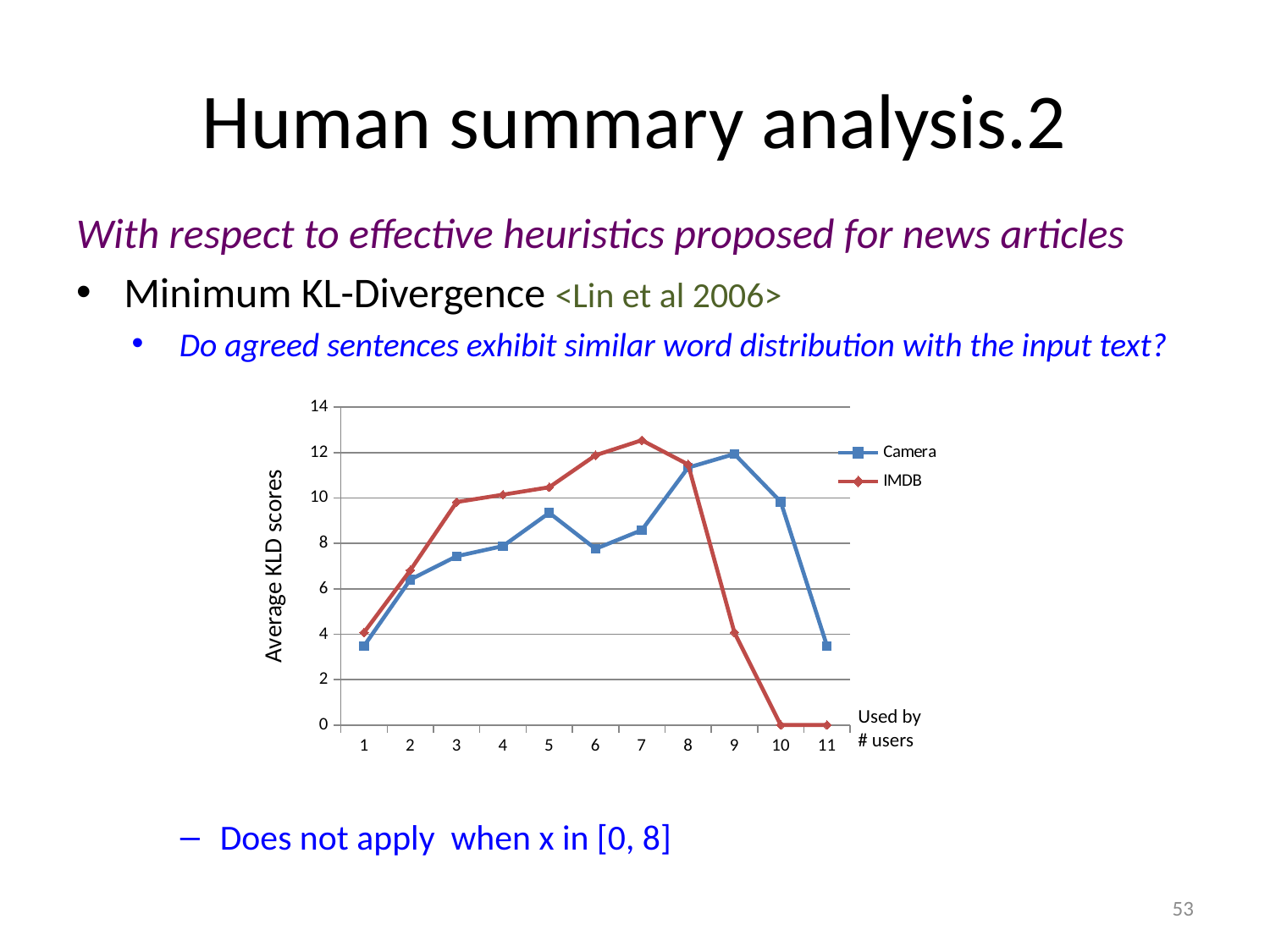
Is the Camera value at x = 9 greater or less than 10? greater At x = 3, which series has the higher value, Camera or IMDB? IMDB Do the IMDB values rise or fall from x = 7 to x = 11? fall Is the IMDB value at x = 7 greater or less than 12? greater At x = 10, which series has the higher value, Camera or IMDB? Camera What is the IMDB value at x = 10? 0 At which x value does the IMDB series reach its highest point? 7 What is the label on the y axis? Average KLD scores Is the IMDB value at x = 9 greater or less than 6? less What kind of chart is shown on the slide? line chart How many points along the x axis does each series have? 11 How many series does the legend list? 2